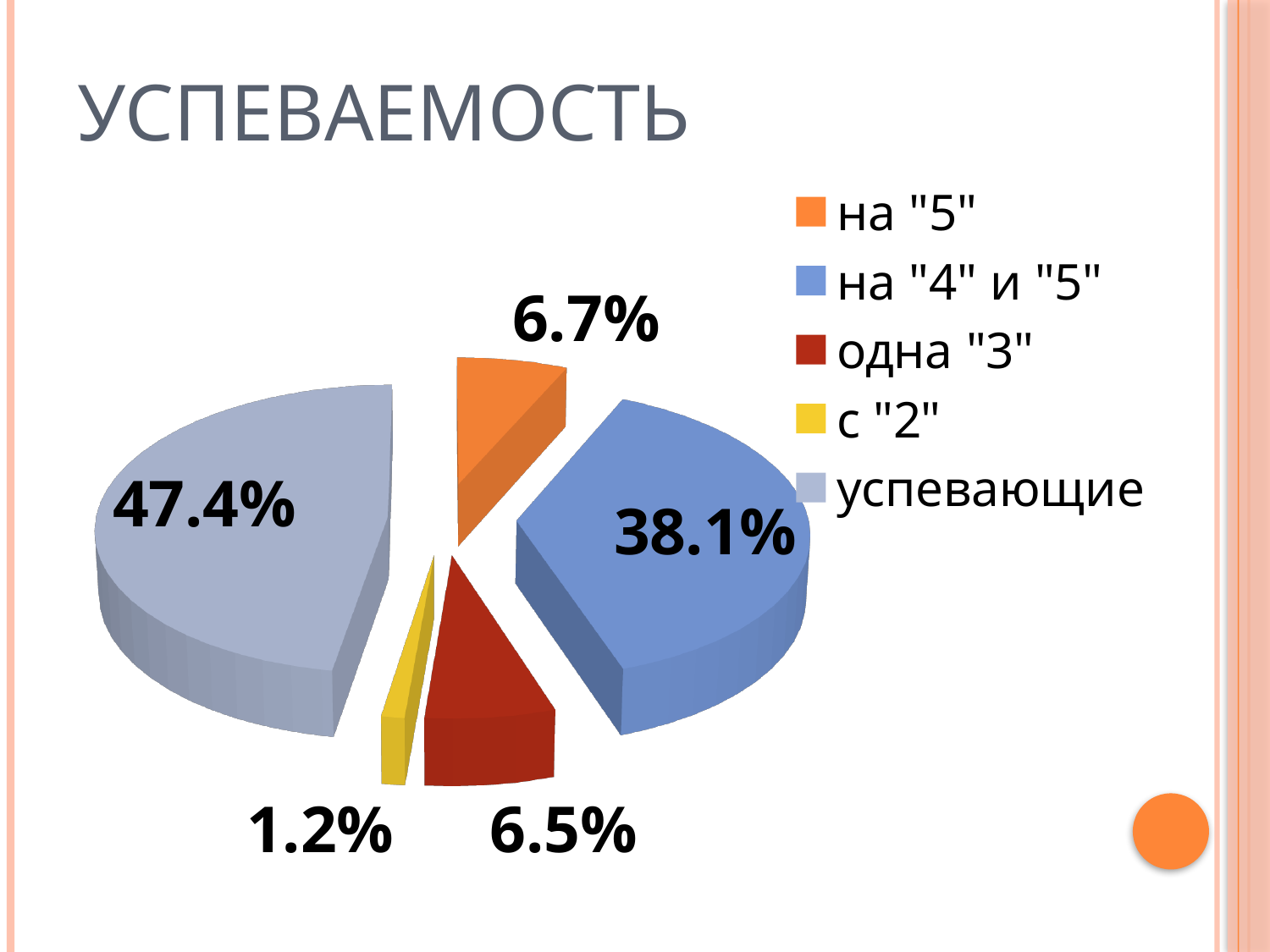
What percentage is shown for the slice labelled одна "3"? 6.5% Which category has the largest slice of the pie? успевающие What percentage is shown for the slice labelled успевающие? 47.4% Which is larger, the slice for на "5" or the slice for одна "3"? на "5" What percentage is shown for the slice labelled на "5"? 6.7% What colour is the slice for с "2"? yellow Which category has the smallest slice of the pie? с "2" What percentage is shown for the slice labelled на "4" и "5"? 38.1% How many categories does the legend list? 5 What percentage is shown for the slice labelled с "2"? 1.2% What kind of chart is shown on the slide? pie chart What is the difference between the percentages for успевающие and на "4" и "5"? 9.3%